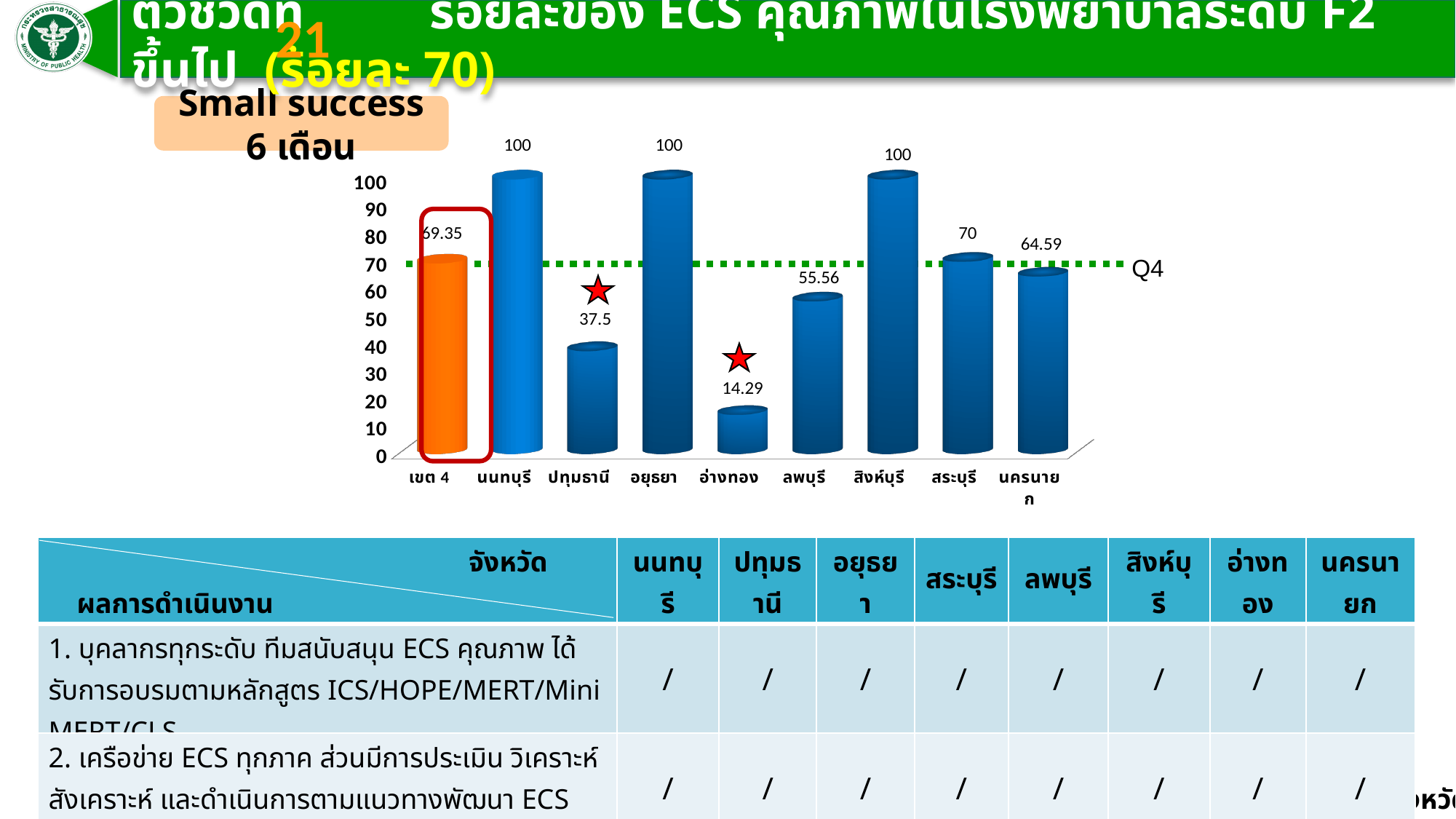
How many categories are shown on the x axis of the chart? 9 What is the value for นครนายก? 64.59 What is the value for ปทุมธานี? 37.5 What is the value for เขต 4? 69.35 What is the difference between the values for นนทบุรี and อ่างทอง? 85.71 What is the difference between the values for สระบุรี and นครนายก? 5.41 What type of chart is shown on the slide? bar chart Which category has the lowest value? อ่างทอง What label is attached to the green dotted horizontal line on the chart? Q4 What is the value for ลพบุรี? 55.56 What is the value for อ่างทอง? 14.29 Which is larger, the value for ลพบุรี or the value for ปทุมธานี? ลพบุรี